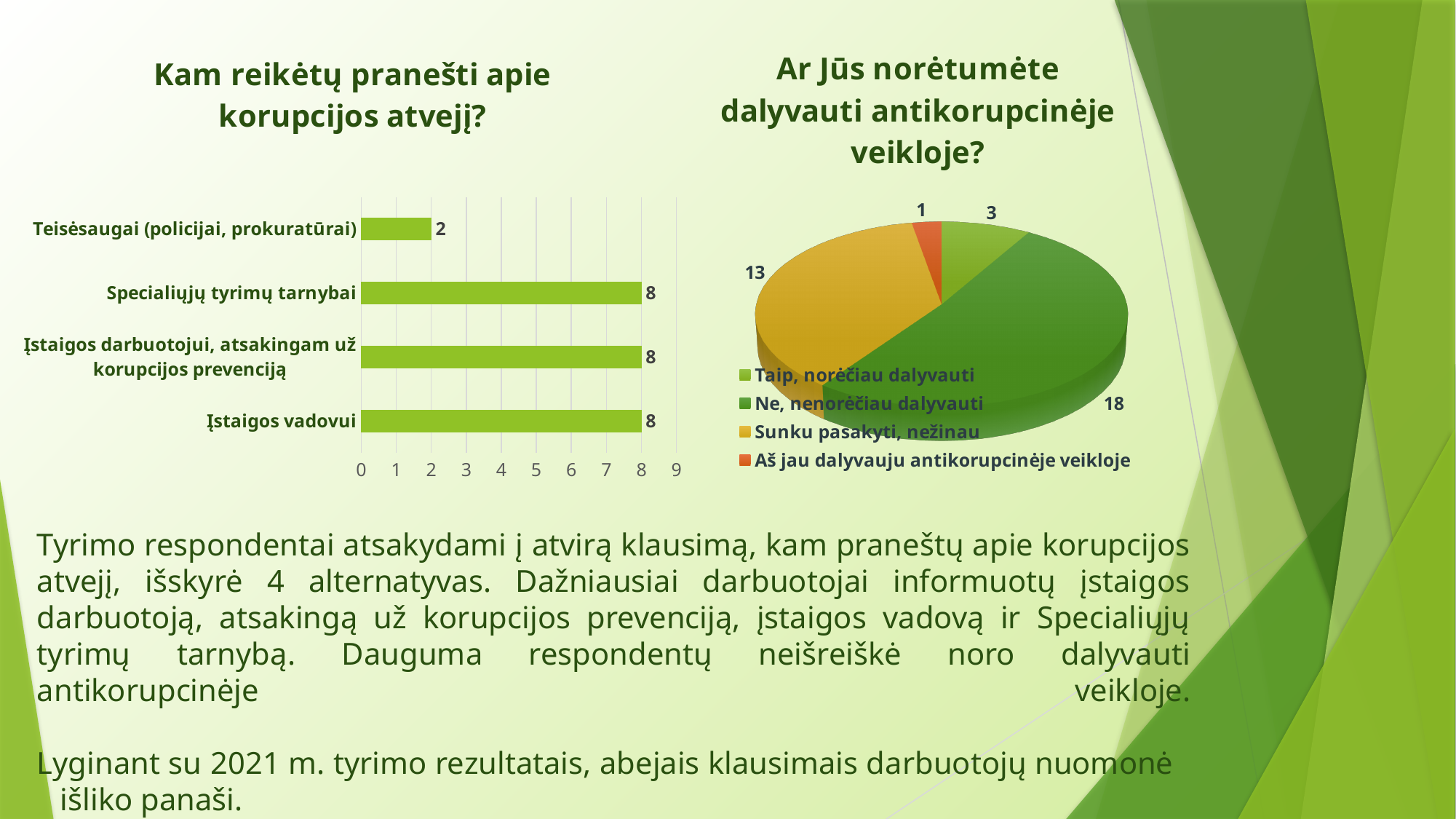
In the chart 'Kam reikėtų pranešti apie korupcijos atvejį?', which category has the lowest value? Teisėsaugai (policijai, prokuratūrai) In the chart 'Kam reikėtų pranešti apie korupcijos atvejį?', what is the difference between the value for Specialiųjų tyrimų tarnybai and the value for Teisėsaugai (policijai, prokuratūrai)? 6 In the pie chart 'Ar Jūs norėtumėte dalyvauti antikorupcinėje veikloje?', what is the value for 'Ne, nenorėčiau dalyvauti'? 18 How many entries does the legend of the pie chart 'Ar Jūs norėtumėte dalyvauti antikorupcinėje veikloje?' list? 4 In the chart 'Kam reikėtų pranešti apie korupcijos atvejį?', what is the value for Teisėsaugai (policijai, prokuratūrai)? 2 In the pie chart 'Ar Jūs norėtumėte dalyvauti antikorupcinėje veikloje?', what is the value for 'Sunku pasakyti, nežinau'? 13 In the pie chart 'Ar Jūs norėtumėte dalyvauti antikorupcinėje veikloje?', which slice is the smallest? Aš jau dalyvauju antikorupcinėje veikloje What kind of chart is 'Ar Jūs norėtumėte dalyvauti antikorupcinėje veikloje?'? pie chart In the chart 'Kam reikėtų pranešti apie korupcijos atvejį?', what is the value for Įstaigos vadovui? 8 In the chart 'Kam reikėtų pranešti apie korupcijos atvejį?', how many categories are shown? 4 In the pie chart 'Ar Jūs norėtumėte dalyvauti antikorupcinėje veikloje?', which is larger: 'Taip, norėčiau dalyvauti' or 'Sunku pasakyti, nežinau'? Sunku pasakyti, nežinau What kind of chart is 'Kam reikėtų pranešti apie korupcijos atvejį?'? bar chart